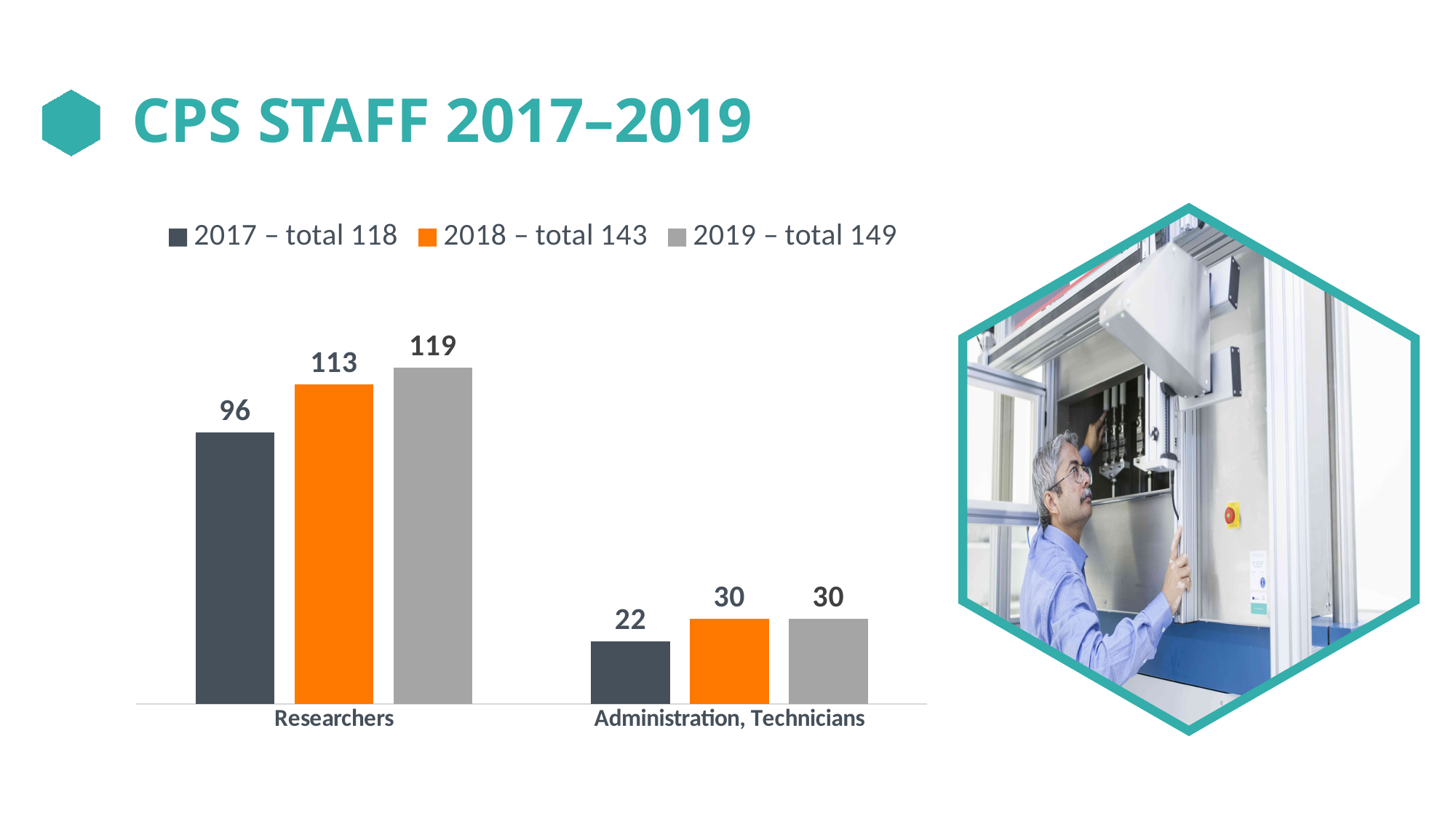
What is the value for Administration, Technicians in 2019? 30 Which is larger: Researchers in 2018 or Researchers in 2017? Researchers in 2018 What is the difference between the number of Researchers in 2019 and in 2017? 23 What kind of chart is shown on the slide? Bar chart How many Researchers were there in 2017? 96 According to the legend, what was the total staff in 2018? 143 What is the value for Researchers in 2018? 113 How many categories are shown on the x axis? 2 What is the difference between Administration, Technicians in 2018 and in 2017? 8 Which year has the highest number of Researchers? 2019 Which year has the lowest value for Administration, Technicians? 2017 How many series does the legend list? 3